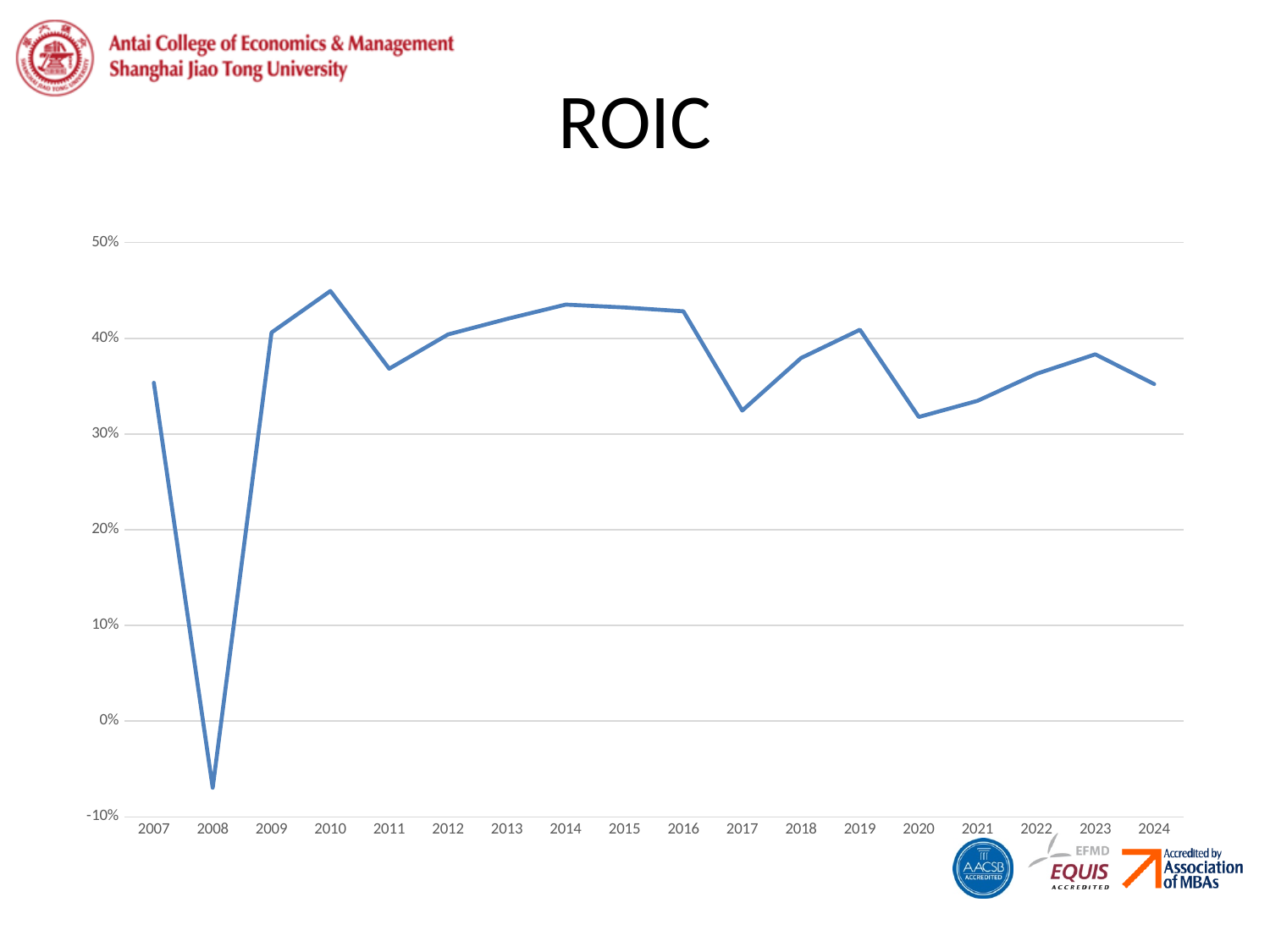
Which year has the highest ROIC value? 2010 Which year has the lowest ROIC value? 2008 Does the ROIC value rise or fall from 2007 to 2008? fall Which year has the larger ROIC value, 2019 or 2020? 2019 What kind of chart is shown on the slide? line chart How many years are plotted along the x axis? 18 Is the value for 2011 greater or less than 40%? less What is the title of the chart? ROIC Does the ROIC value rise or fall from 2020 to 2023? rise Is the value for 2008 greater or less than 0%? less Is the value for 2020 greater or less than 30%? greater